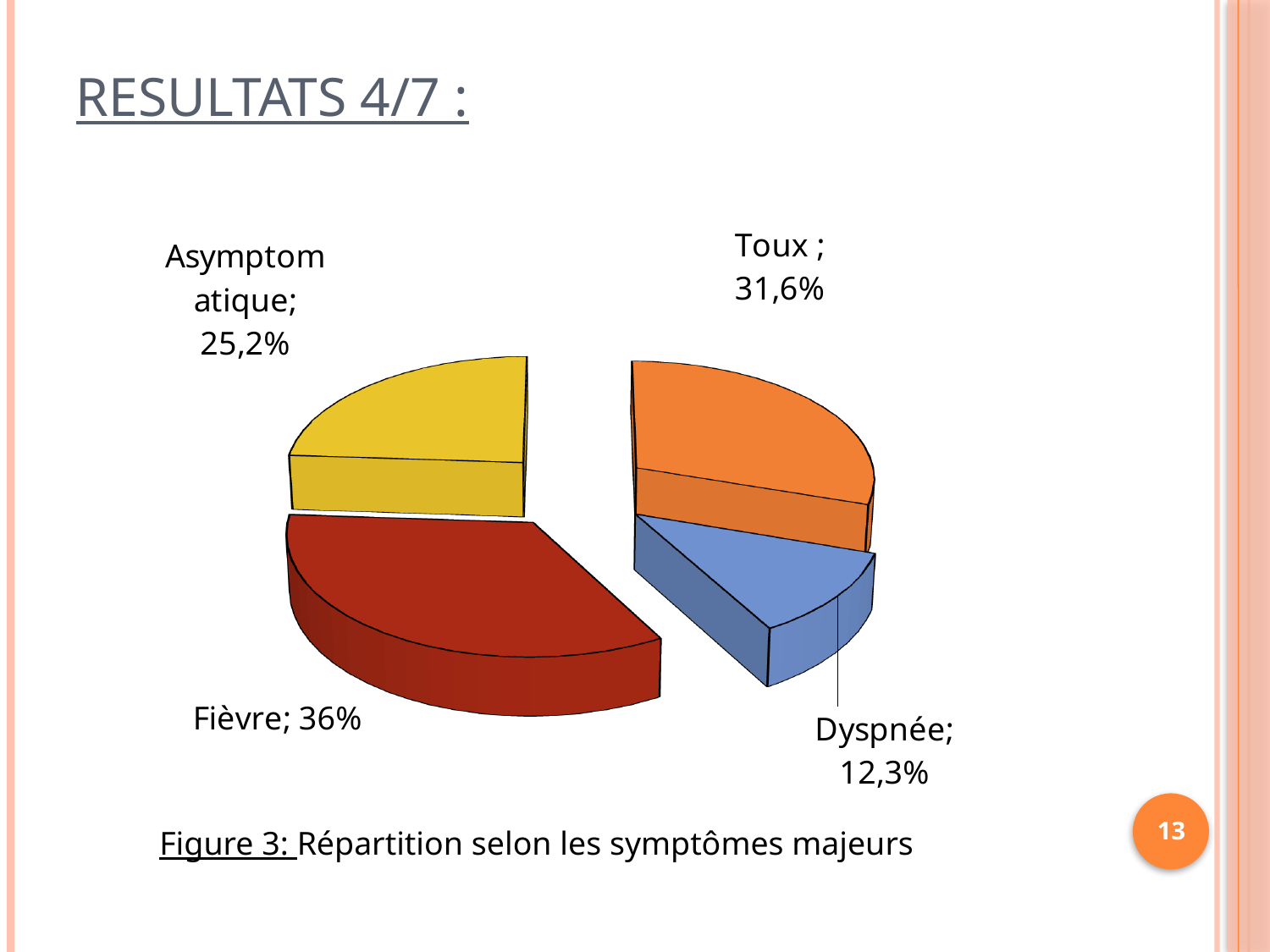
What is the value for Toux? 31,6% What kind of chart is shown on the slide? pie chart How many slices does the pie chart have? 4 What is the difference between the share for Fièvre and the share for Dyspnée? 23,7% What is the value for Dyspnée? 12,3% What is the difference between the share for Toux and the share for Asymptomatique? 6,4% What is the caption of the figure below the chart? Figure 3: Répartition selon les symptômes majeurs Which category has the smallest share of the pie? Dyspnée Which category has the largest share of the pie? Fièvre Which is larger, the share for Toux or the share for Asymptomatique? Toux What is the value for Fièvre? 36% What is the value for Asymptomatique? 25,2%